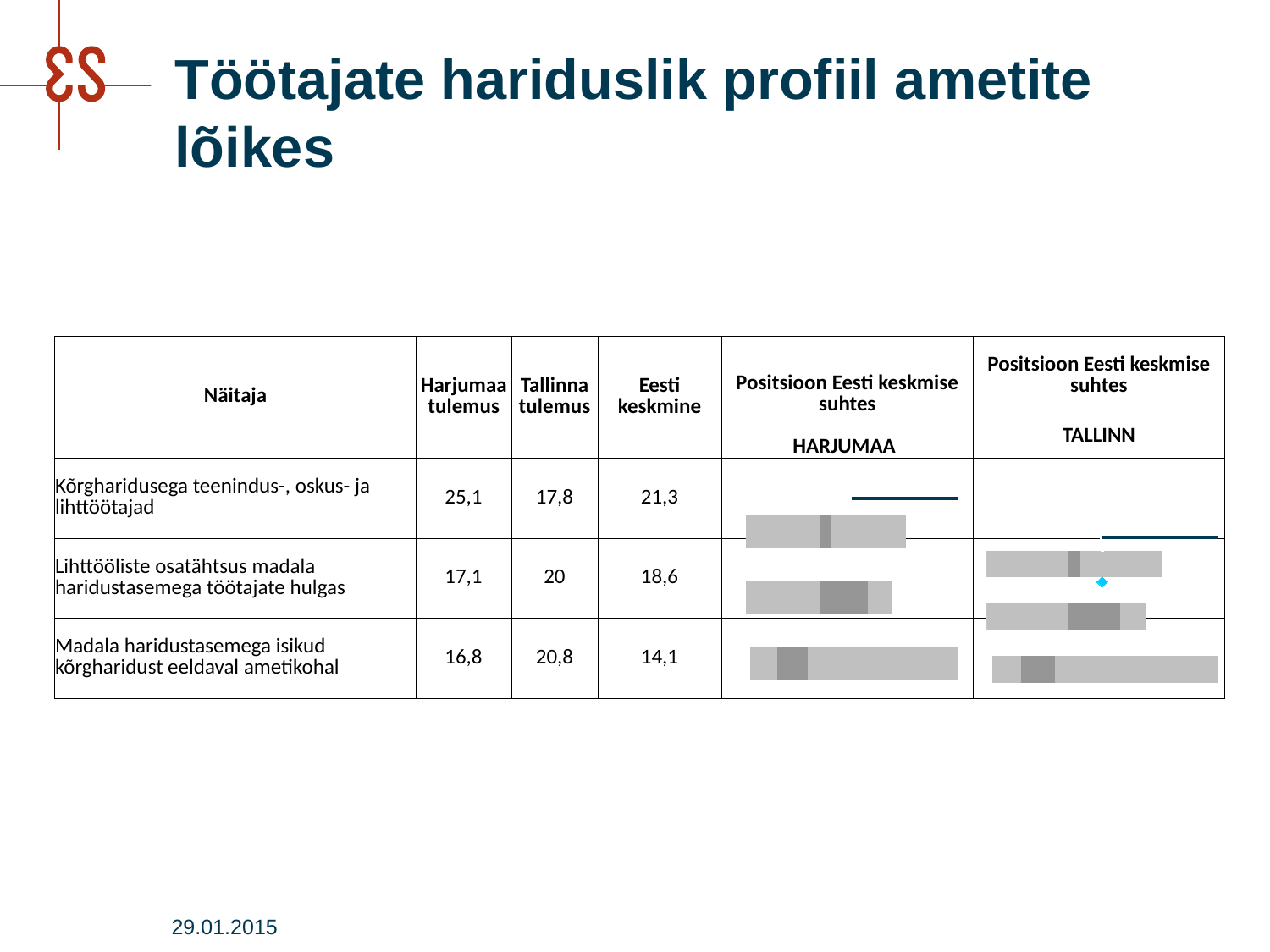
What is the Tallinna tulemus for "Lihttööliste osatähtsus madala haridustasemega töötajate hulgas"? 20 What is the Tallinna tulemus for "Kõrgharidusega teenindus-, oskus- ja lihttöötajad"? 17,8 What is the Harjumaa tulemus for "Kõrgharidusega teenindus-, oskus- ja lihttöötajad"? 25,1 Which indicator has the highest Harjumaa tulemus? Kõrgharidusega teenindus-, oskus- ja lihttöötajad What is the Eesti keskmine for "Madala haridustasemega isikud kõrgharidust eeldaval ametikohal"? 14,1 For "Kõrgharidusega teenindus-, oskus- ja lihttöötajad", which is larger: the Harjumaa tulemus or the Tallinna tulemus? Harjumaa tulemus What kind of chart is used in the "Positsioon Eesti keskmise suhtes" columns? Bar chart What is the difference between the Tallinna tulemus and the Eesti keskmine for "Madala haridustasemega isikud kõrgharidust eeldaval ametikohal"? 6,7 Which indicator has the lowest Eesti keskmine? Madala haridustasemega isikud kõrgharidust eeldaval ametikohal For "Madala haridustasemega isikud kõrgharidust eeldaval ametikohal", which is larger: the Tallinna tulemus or the Eesti keskmine? Tallinna tulemus What is the difference between the Harjumaa tulemus and the Eesti keskmine for "Kõrgharidusega teenindus-, oskus- ja lihttöötajad"? 3,8 How many indicators (rows) are shown in the table? 3